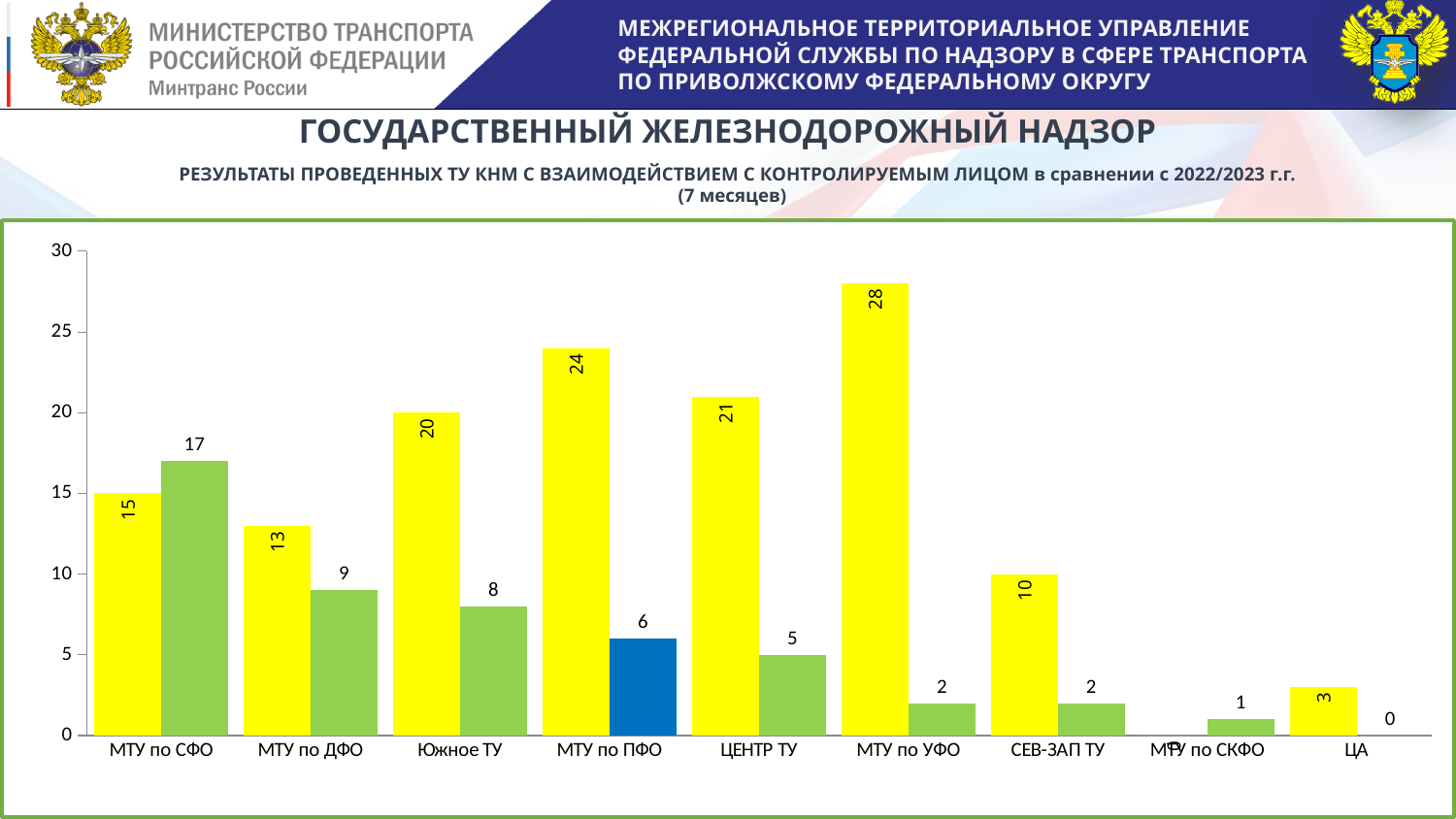
What kind of chart is shown on the slide? bar chart How many categories are shown on the x axis of the chart? 9 Which category has the highest green bar? МТУ по СФО What is the value of the blue bar for МТУ по ПФО? 6 What is the value of the yellow bar for МТУ по УФО? 28 What is the value of the green bar for МТУ по СКФО? 1 What colour is the second bar for МТУ по ПФО? blue What is the difference between the yellow bar (24) and the blue bar (6) for МТУ по ПФО? 18 Which category has the highest yellow bar? МТУ по УФО Is the yellow bar for МТУ по ПФО greater or less than 20? greater Which is larger: the yellow bar for ЦЕНТР ТУ or the yellow bar for Южное ТУ? ЦЕНТР ТУ What is the value of the green bar for МТУ по СФО? 17